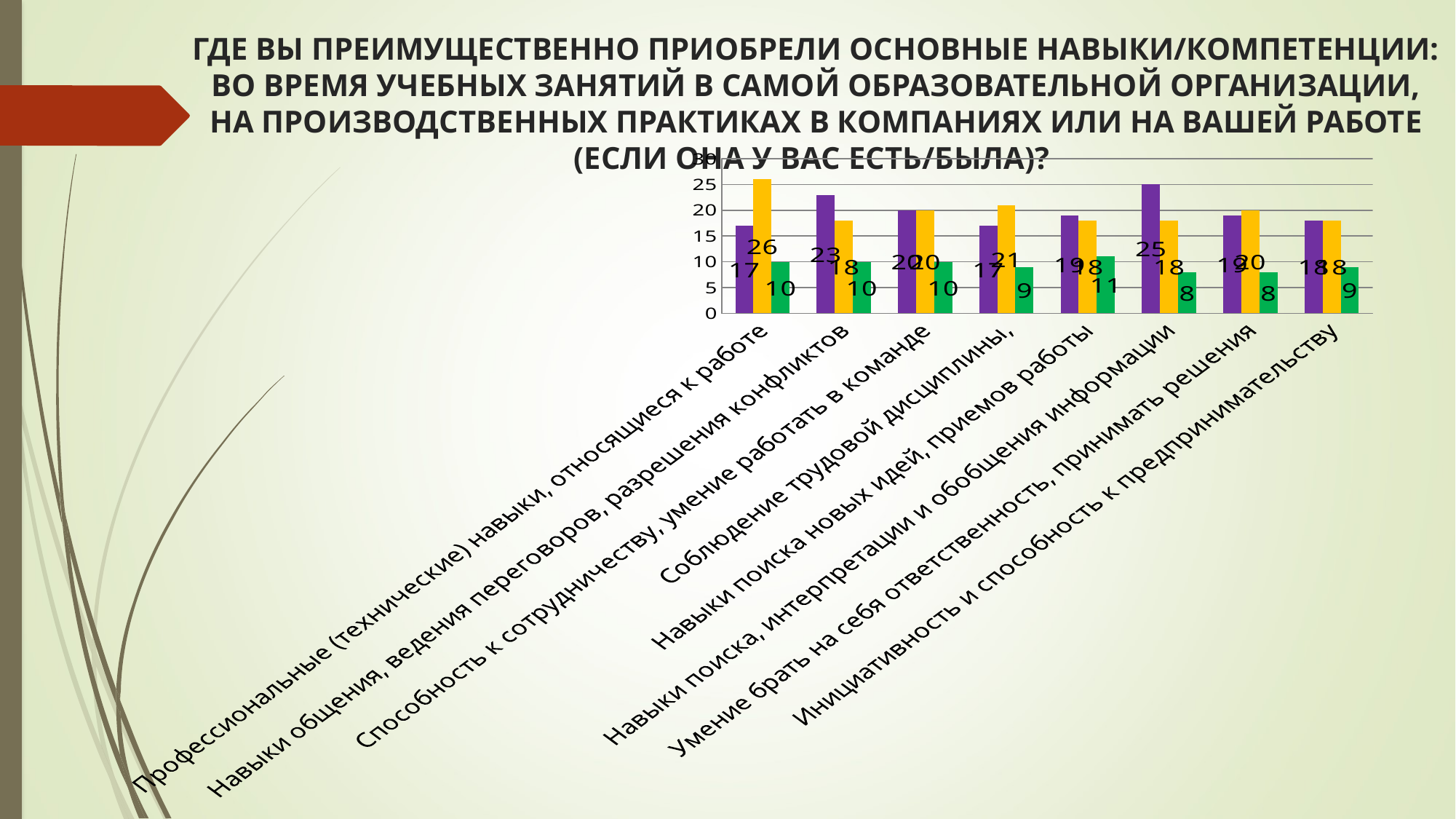
Which category has the highest yellow bar? Профессиональные (технические) навыки, относящиеся к работе What kind of chart is shown on the slide? bar chart What is the total of the three bars for 'Инициативность и способность к предпринимательству'? 45 What is the value of the green bar for 'Навыки поиска новых идей, приемов работы'? 11 What is the value of the purple bar for 'Навыки поиска, интерпретации и обобщения информации'? 25 What is the value of the yellow bar for 'Профессиональные (технические) навыки, относящиеся к работе'? 26 For 'Соблюдение трудовой дисциплины', which is larger: the purple bar or the yellow bar? the yellow bar Which category has the highest purple bar? Навыки поиска, интерпретации и обобщения информации What is the value of the purple bar for 'Навыки общения, ведения переговоров, разрешения конфликтов'? 23 How many categories are shown on the x axis of the chart? 8 What is the difference between the yellow bar and the purple bar for 'Профессиональные (технические) навыки, относящиеся к работе'? 9 Is the purple bar for 'Навыки поиска, интерпретации и обобщения информации' greater or less than 20? greater